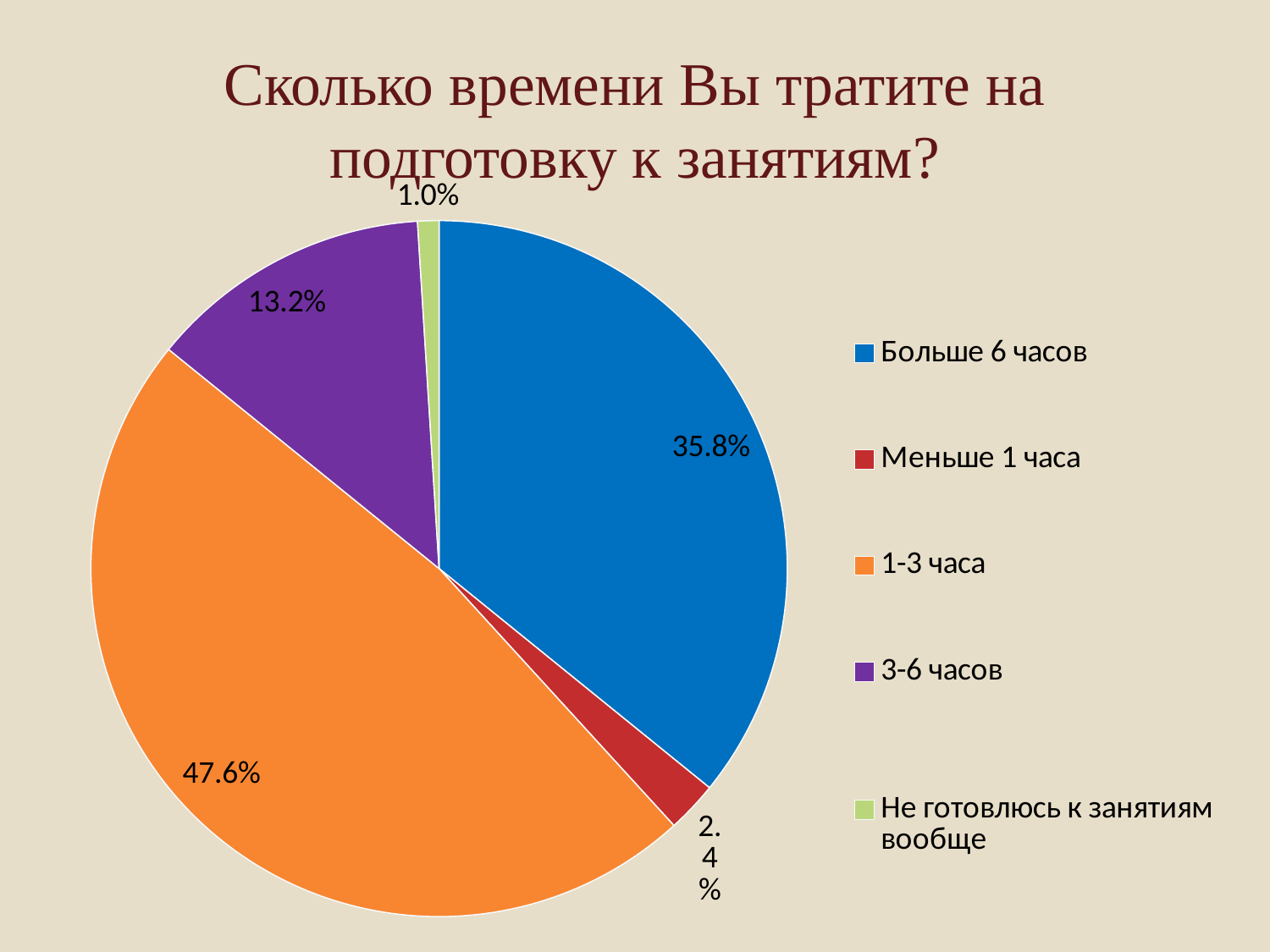
Which category has the largest slice of the pie? 1-3 часа What is the share for "3-6 часов"? 13.2% What is the share for "1-3 часа"? 47.6% Which is larger: the share for "3-6 часов" or the share for "Меньше 1 часа"? 3-6 часов What is the title of the chart? Сколько времени Вы тратите на подготовку к занятиям? Which category has the smallest slice of the pie? Не готовлюсь к занятиям вообще How many categories does the pie chart have? 5 What is the share for "Не готовлюсь к занятиям вообще"? 1.0% What is the share for "Больше 6 часов"? 35.8% What is the share for "Меньше 1 часа"? 2.4% What is the difference between the shares for "1-3 часа" and "Больше 6 часов"? 11.8% What type of chart is shown on the slide? pie chart